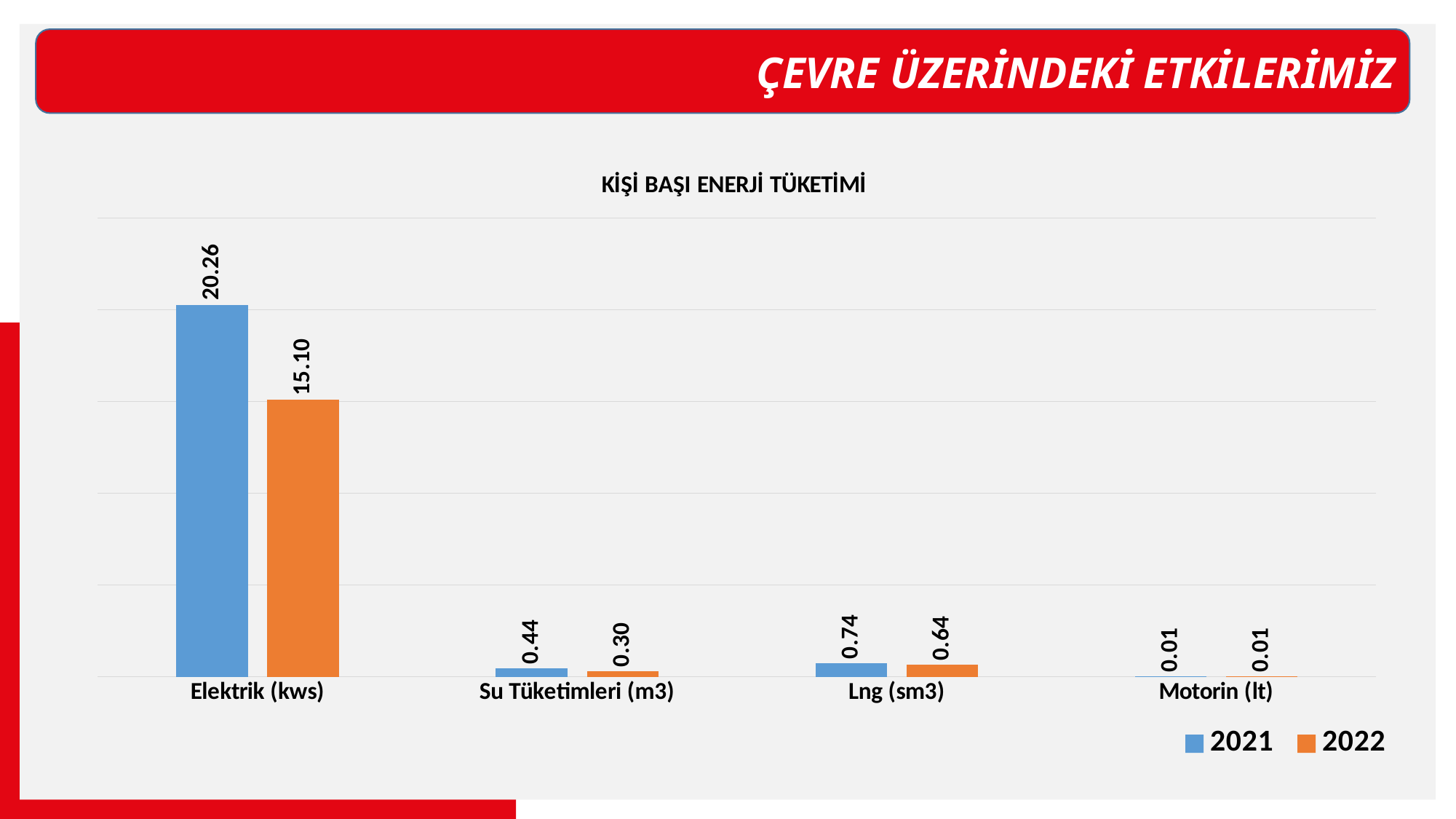
What is the 2022 value for Motorin (lt)? 0.01 What kind of chart is shown on the slide? Bar chart Which category has the lowest 2022 value? Motorin (lt) What is the difference between the 2021 and 2022 values for Elektrik (kws)? 5.16 Which is larger for Lng (sm3): the 2021 value or the 2022 value? 2021 What is the 2022 value for Lng (sm3)? 0.64 What is the 2021 value for Elektrik (kws)? 20.26 What is the 2022 value for Elektrik (kws)? 15.10 How many series does the legend list? 2 How many categories are shown on the x axis? 4 Which category has the highest 2021 value? Elektrik (kws) What is the 2021 value for Su Tüketimleri (m3)? 0.44